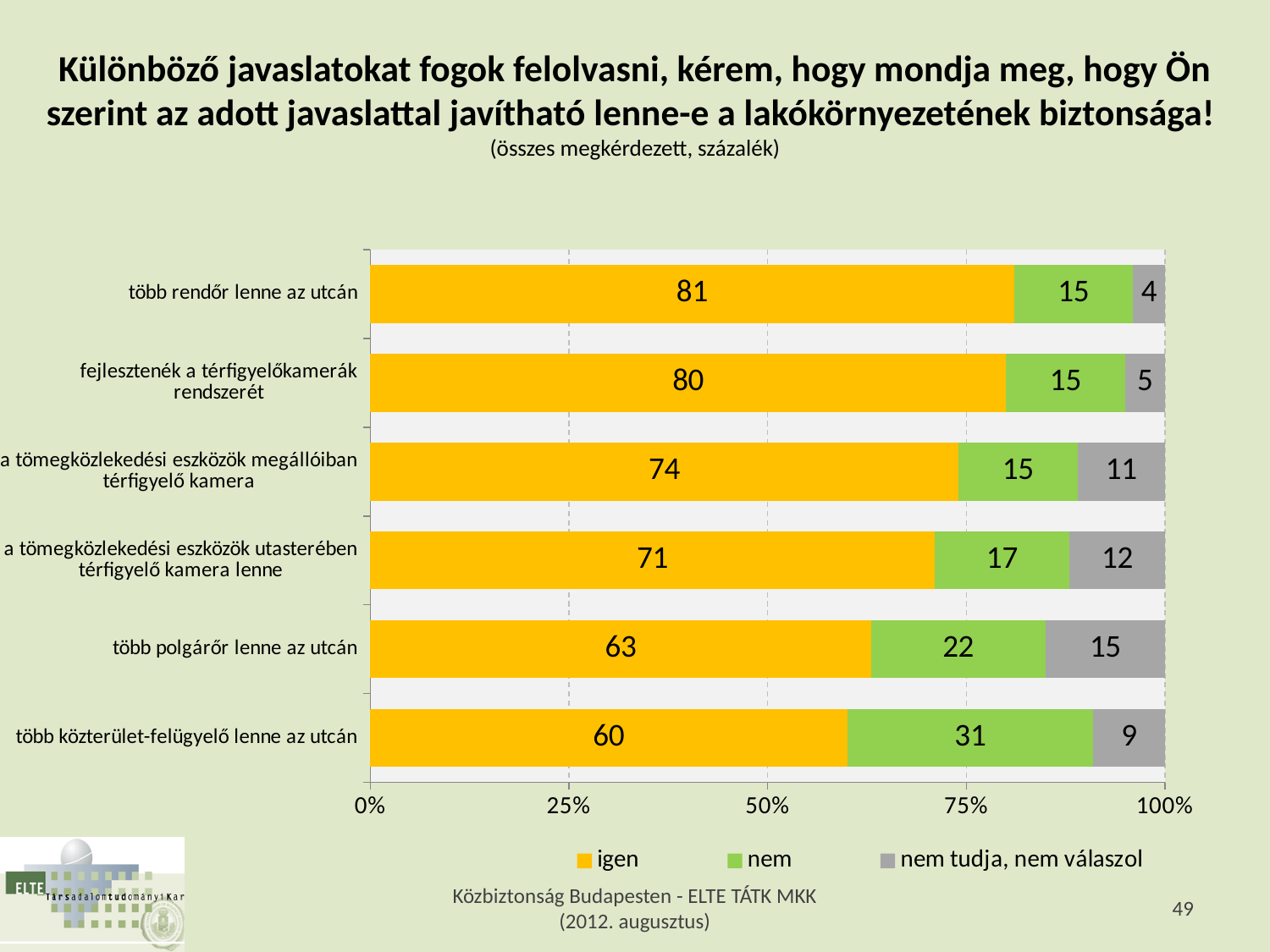
What is the 'nem' value for 'több közterület-felügyelő lenne az utcán'? 31 Which category has the lowest 'igen' value? több közterület-felügyelő lenne az utcán How many categories are shown in the chart? 6 Which is larger: the 'nem' value for 'több polgárőr lenne az utcán' or the 'nem' value for 'a tömegközlekedési eszközök utasterében térfigyelő kamera lenne'? több polgárőr lenne az utcán What kind of chart is shown on the slide? stacked bar chart What is the difference between the 'igen' values for 'több rendőr lenne az utcán' and 'több polgárőr lenne az utcán'? 18 How many series does the legend list? 3 What is the total of the stacked bar for 'a tömegközlekedési eszközök megállóiban térfigyelő kamera'? 100 Which category has the highest 'igen' value? több rendőr lenne az utcán What is the 'igen' value for 'több rendőr lenne az utcán'? 81 Which colour represents the 'igen' series in the chart? yellow What is the 'nem tudja, nem válaszol' value for 'több polgárőr lenne az utcán'? 15